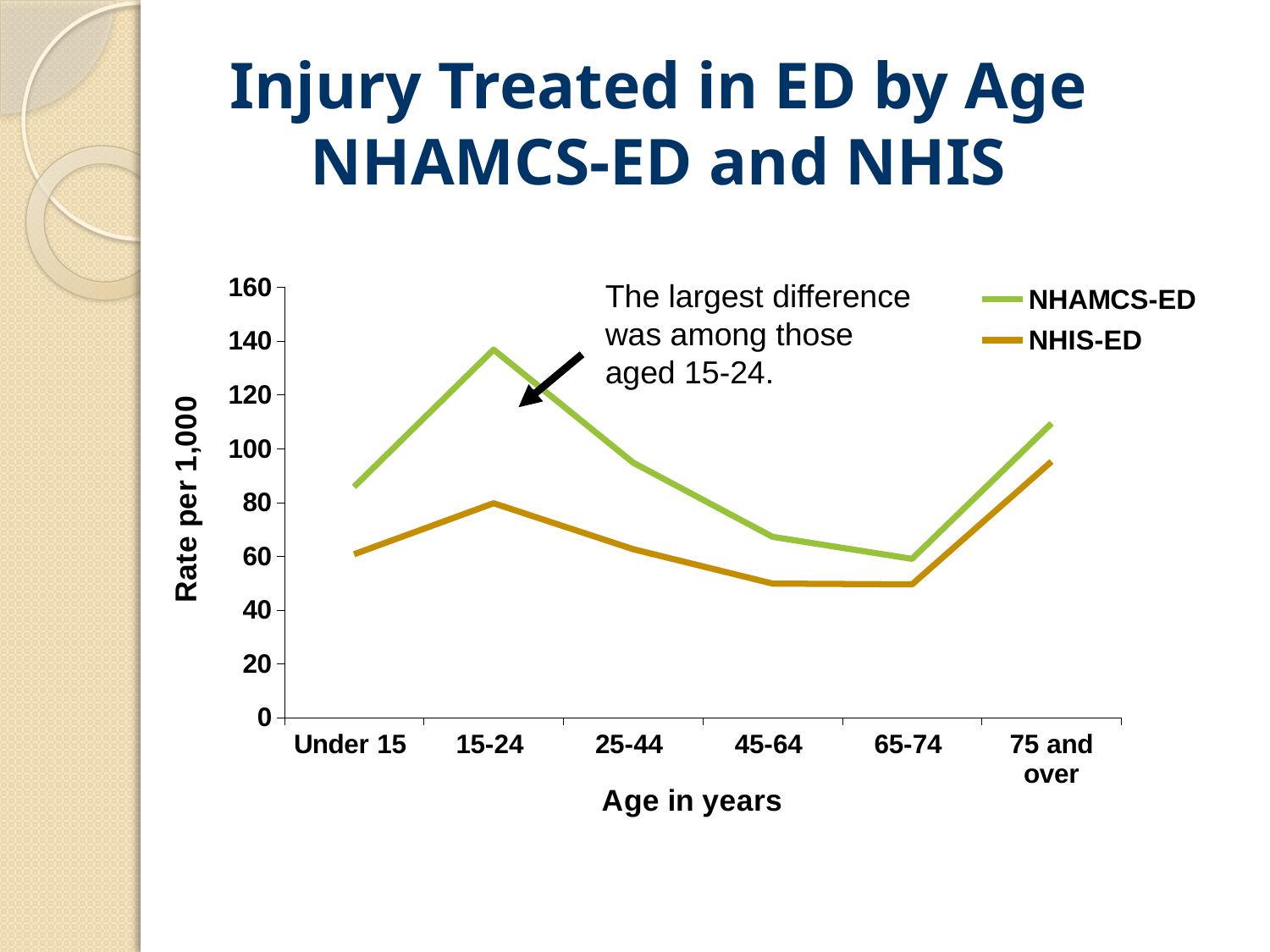
For which age group is the NHIS-ED rate highest? 75 and over What is the label on the y axis of the chart? Rate per 1,000 For which age group is the NHAMCS-ED rate highest? 15-24 What kind of chart is shown on the slide? line chart Is the NHIS-ED value for ages 75 and over greater or less than 80? greater Is the NHIS-ED value for ages 45-64 greater or less than 60? less For which age group is the NHAMCS-ED rate lowest? 65-74 How many series does the legend list? 2 Does the NHAMCS-ED line rise or fall from ages 15-24 to ages 65-74? fall Is the NHAMCS-ED value for ages 15-24 greater or less than 120? greater How many age categories are shown on the x axis? 6 Which series has the larger value for ages 15-24, NHAMCS-ED or NHIS-ED? NHAMCS-ED